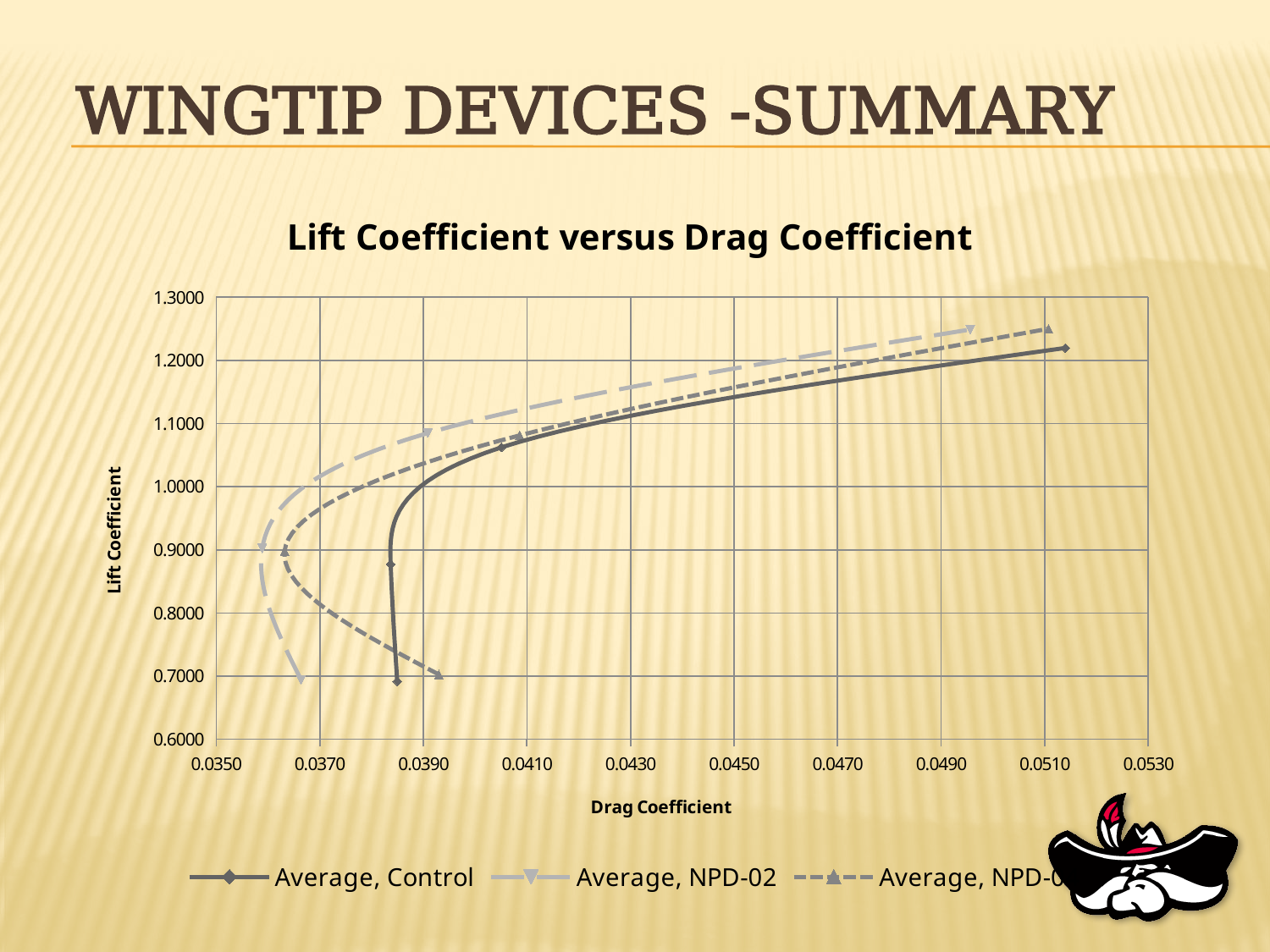
Which series has the largest minimum drag coefficient (its curve stays furthest to the right at the low-lift end)? Average, Control In the upper portion of the curves, does the lift coefficient rise or fall as the drag coefficient increases? rise What is the label of the horizontal axis? Drag Coefficient Is the highest lift coefficient reached by the Average, NPD-02 series greater or less than 1.2000? greater What kind of chart is shown on the slide? Line chart What is the title of the chart? Lift Coefficient versus Drag Coefficient Is the largest drag coefficient reached by the Average, Control series greater or less than 0.0490? greater Which series reaches a higher maximum lift coefficient, Average, NPD-02 or Average, Control? Average, NPD-02 Is the highest lift coefficient reached by the Average, Control series greater or less than 1.2000? greater How many series does the chart legend list? 3